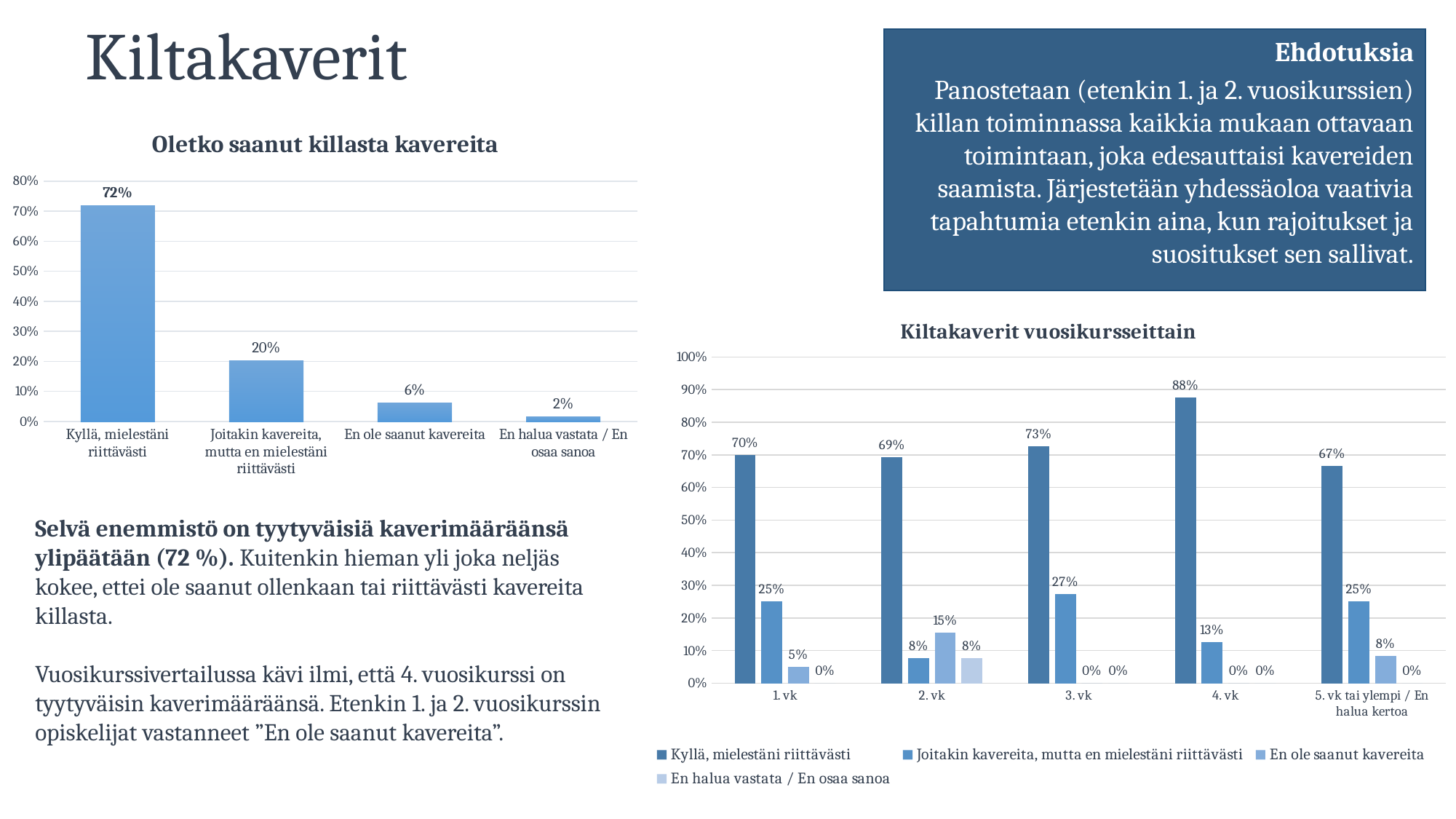
In the chart 'Oletko saanut killasta kavereita', what is the difference between 'Kyllä, mielestäni riittävästi' and 'Joitakin kavereita, mutta en mielestäni riittävästi'? 52% In the chart 'Kiltakaverit vuosikursseittain', which is larger: 'Joitakin kavereita, mutta en mielestäni riittävästi' in '3. vk' or in '4. vk'? 3. vk In the chart 'Kiltakaverit vuosikursseittain', what is the difference between 'Kyllä, mielestäni riittävästi' in '4. vk' and in '5. vk tai ylempi / En halua kertoa'? 21% How many series does the legend of the chart 'Kiltakaverit vuosikursseittain' list? 4 In the chart 'Oletko saanut killasta kavereita', which category has the lowest value? En halua vastata / En osaa sanoa What kind of chart is 'Oletko saanut killasta kavereita'? Bar chart In the chart 'Kiltakaverit vuosikursseittain', what is the value for 'Kyllä, mielestäni riittävästi' in '4. vk'? 88% In the chart 'Kiltakaverit vuosikursseittain', which year group has the highest value for 'Kyllä, mielestäni riittävästi'? 4. vk In the chart 'Kiltakaverit vuosikursseittain', how many year-group categories are shown on the x axis? 5 How many categories are shown in the chart 'Oletko saanut killasta kavereita'? 4 In the chart 'Kiltakaverit vuosikursseittain', what is the value for 'En ole saanut kavereita' in '2. vk'? 15% In the chart 'Oletko saanut killasta kavereita', what is the value for 'Kyllä, mielestäni riittävästi'? 72%